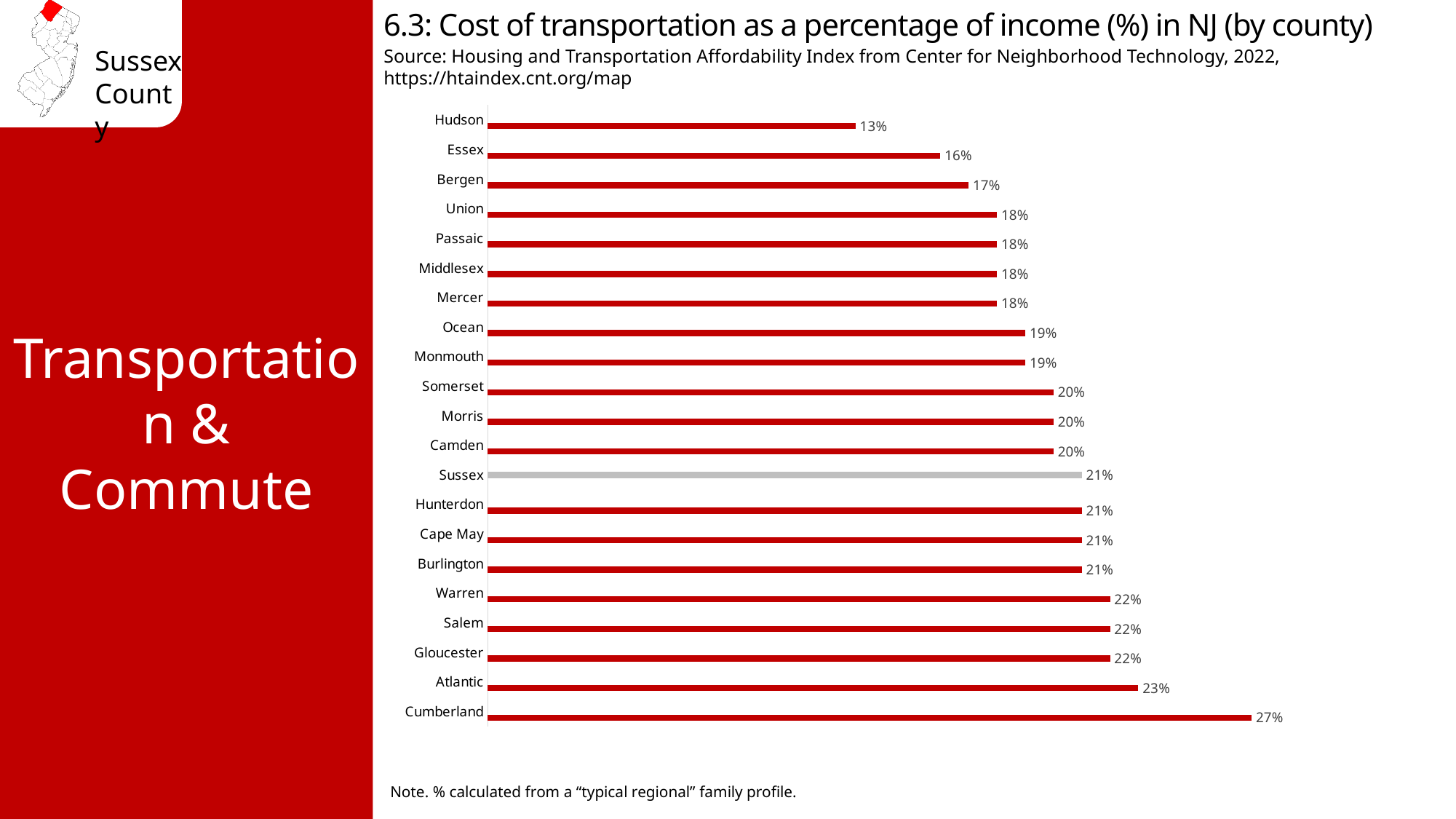
What kind of chart is shown on the slide? Bar chart Which county has the highest cost of transportation as a percentage of income? Cumberland What is the title of the chart? 6.3: Cost of transportation as a percentage of income (%) in NJ (by county) What is the cost of transportation as a percentage of income for Atlantic County? 23% What is the cost of transportation as a percentage of income for Hudson County? 13% Which has a higher cost of transportation as a percentage of income, Bergen or Warren? Warren What is the difference in percentage points between Cumberland and Hudson? 14 Which county has the lowest cost of transportation as a percentage of income? Hudson Which county's bar is shown in grey rather than red? Sussex What is the cost of transportation as a percentage of income for Sussex County? 21% What is the difference in percentage points between Sussex and Essex? 5 How many counties are shown in the chart? 21